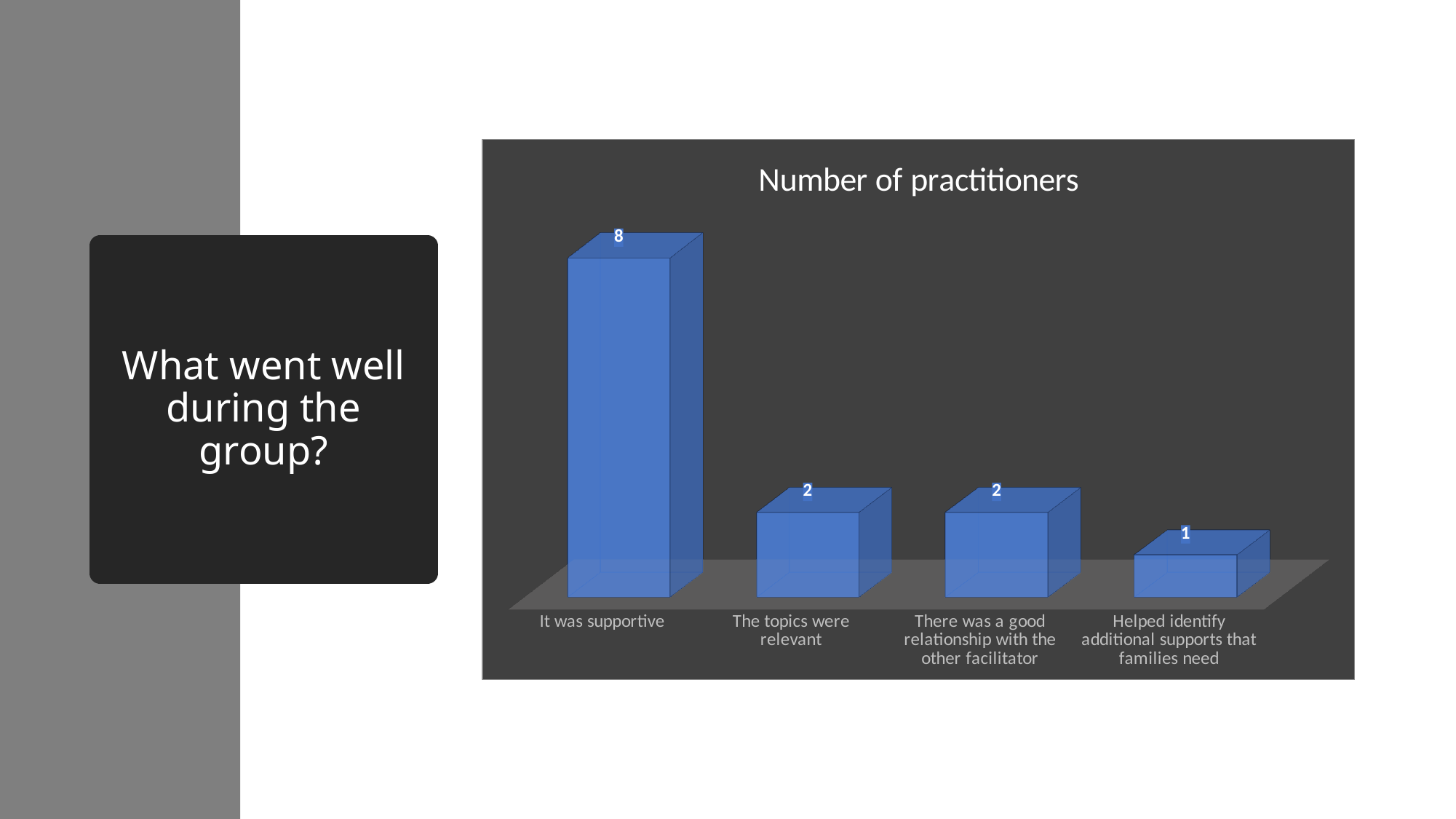
What is the difference between the values for "It was supportive" and "The topics were relevant"? 6 Which category has the lowest number of practitioners? Helped identify additional supports that families need Do the values rise or fall from left to right across the categories? Fall What is the value for "It was supportive"? 8 What is the value for "The topics were relevant"? 2 What is the difference between the values for "It was supportive" and "Helped identify additional supports that families need"? 7 Which is larger: the value for "There was a good relationship with the other facilitator" or the value for "Helped identify additional supports that families need"? There was a good relationship with the other facilitator Which category has the highest number of practitioners? It was supportive What kind of chart is shown on the slide? Bar chart What is the value for "Helped identify additional supports that families need"? 1 What is the title of the chart? Number of practitioners How many categories are shown in the chart? 4